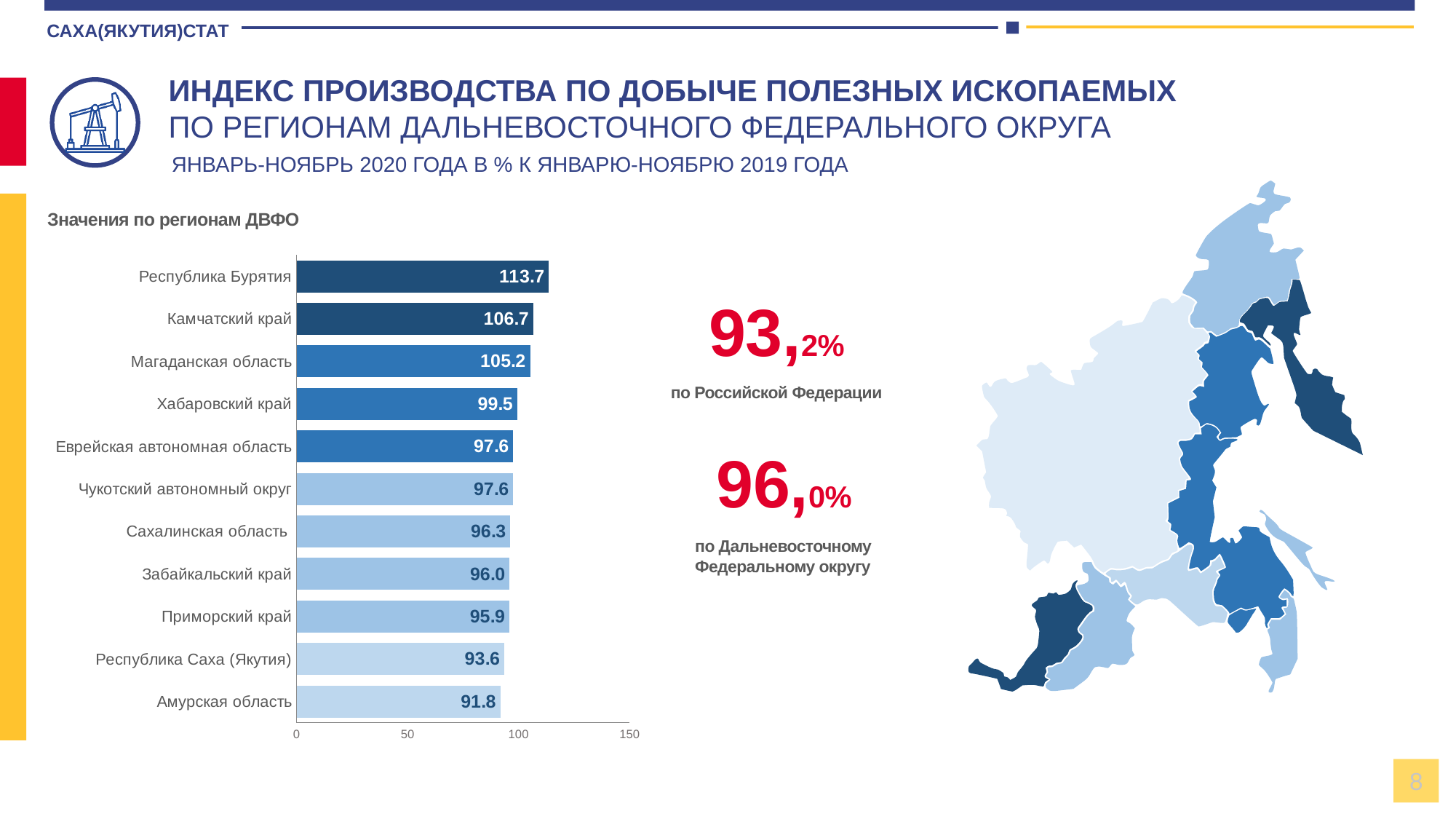
How many regions are shown in the bar chart? 11 What is the value for Республика Саха (Якутия) in the bar chart? 93.6 Which region has the highest value in the bar chart? Республика Бурятия What type of chart is used to show the values by region? bar chart Which has a larger value, Сахалинская область or Приморский край? Сахалинская область What is the title of the chart on the slide? Значения по регионам ДВФО What is the difference between the values for Республика Бурятия and Амурская область? 21.9 Which region has the lowest value in the bar chart? Амурская область What is the difference between the values for Камчатский край and Магаданская область? 1.5 What is the value for Хабаровский край in the bar chart? 99.5 Is the value for Магаданская область greater or less than 100? greater What is the value for Республика Бурятия in the bar chart? 113.7